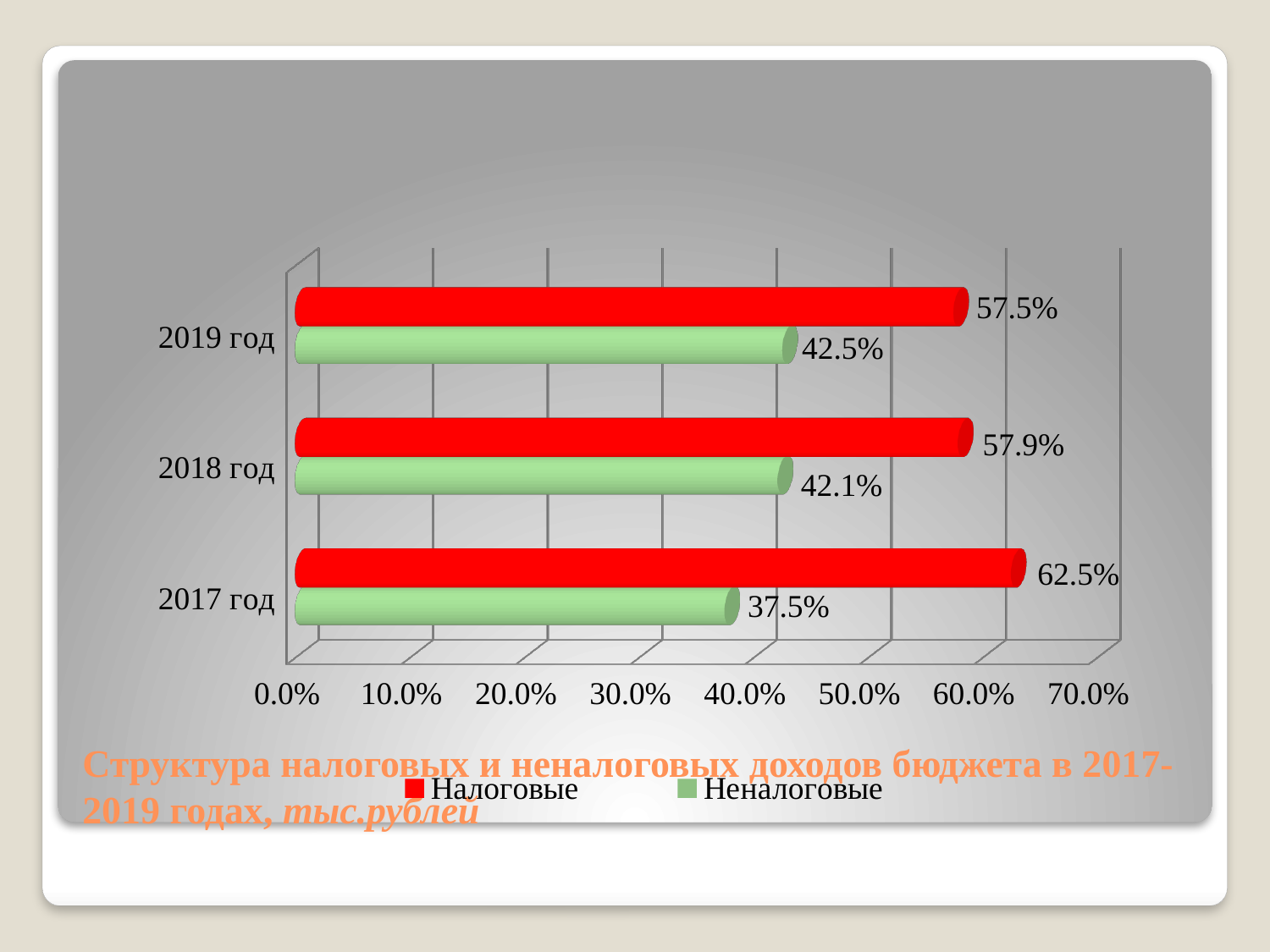
What is the value for Неналоговые in 2017 год? 37.5% What is the difference between Налоговые and Неналоговые in 2017 год? 25.0% Is the value for Налоговые in 2018 год greater or less than 50.0%? greater What is the value for Налоговые in 2019 год? 57.5% How many years are shown on the chart? 3 What is the value for Неналоговые in 2018 год? 42.1% Which is larger in 2018 год, Налоговые or Неналоговые? Налоговые What kind of chart is shown on the slide? bar chart Which colour represents Неналоговые in the legend? green In which year is the Неналоговые share lowest? 2017 год How many series does the legend list? 2 In which year is the Налоговые share highest? 2017 год